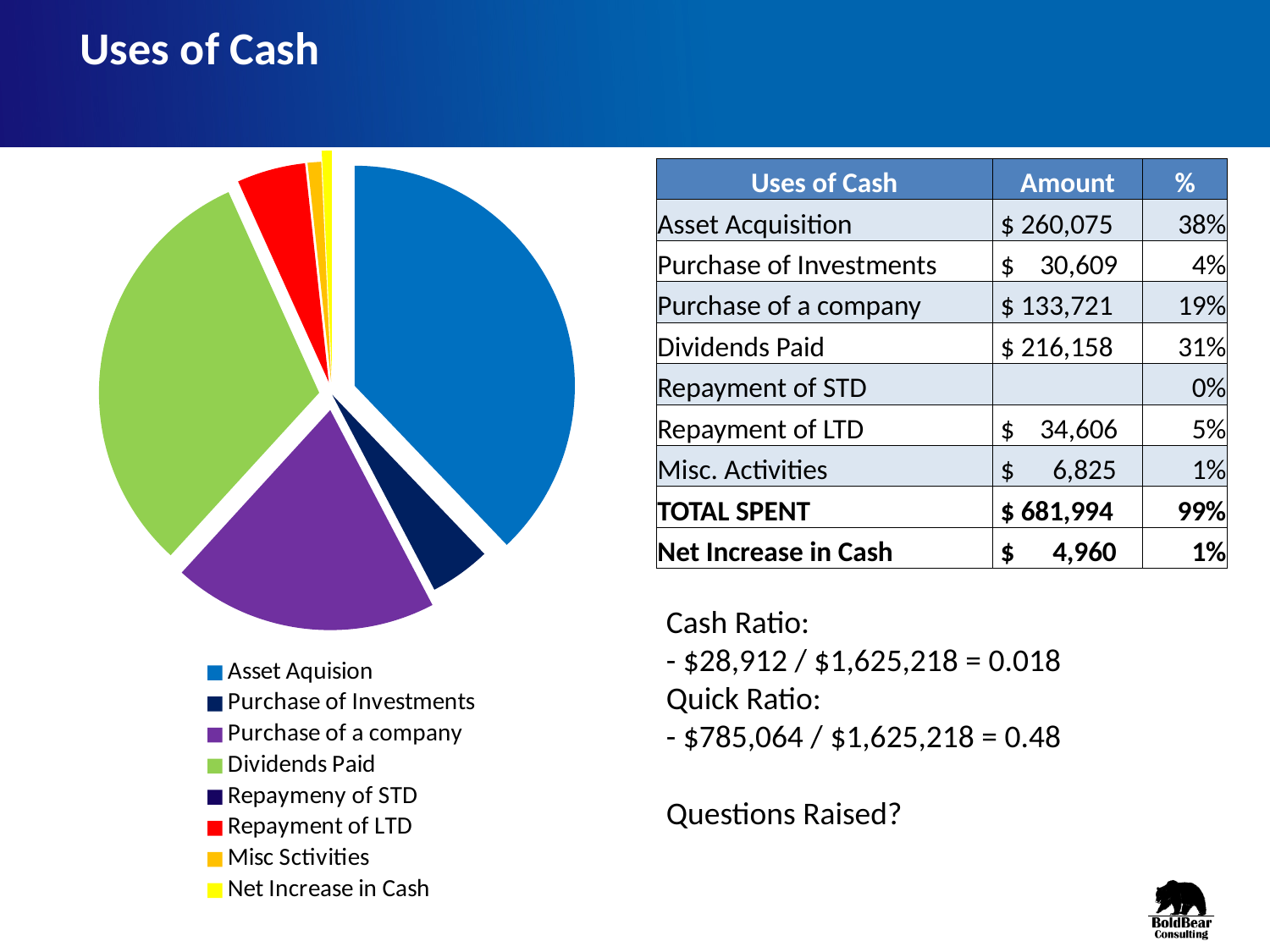
What kind of chart is shown on the slide? pie chart What is the amount shown for Purchase of a company? $ 133,721 What is the difference between the Asset Acquisition amount and the Dividends Paid amount? $43,917 What colour is the Dividends Paid slice in the pie chart? green What is the amount shown for Repayment of LTD? $ 34,606 According to the table, what share of cash use is Asset Acquisition? 38% According to the table, what share of cash use is Dividends Paid? 31% How many entries does the pie chart's legend list? 8 What is the amount shown for Misc. Activities? $ 6,825 Which use of cash has the largest slice of the pie chart? Asset Acquisition Which is larger, the amount for Dividends Paid or the amount for Purchase of a company? Dividends Paid What is the TOTAL SPENT amount shown in the table? $ 681,994